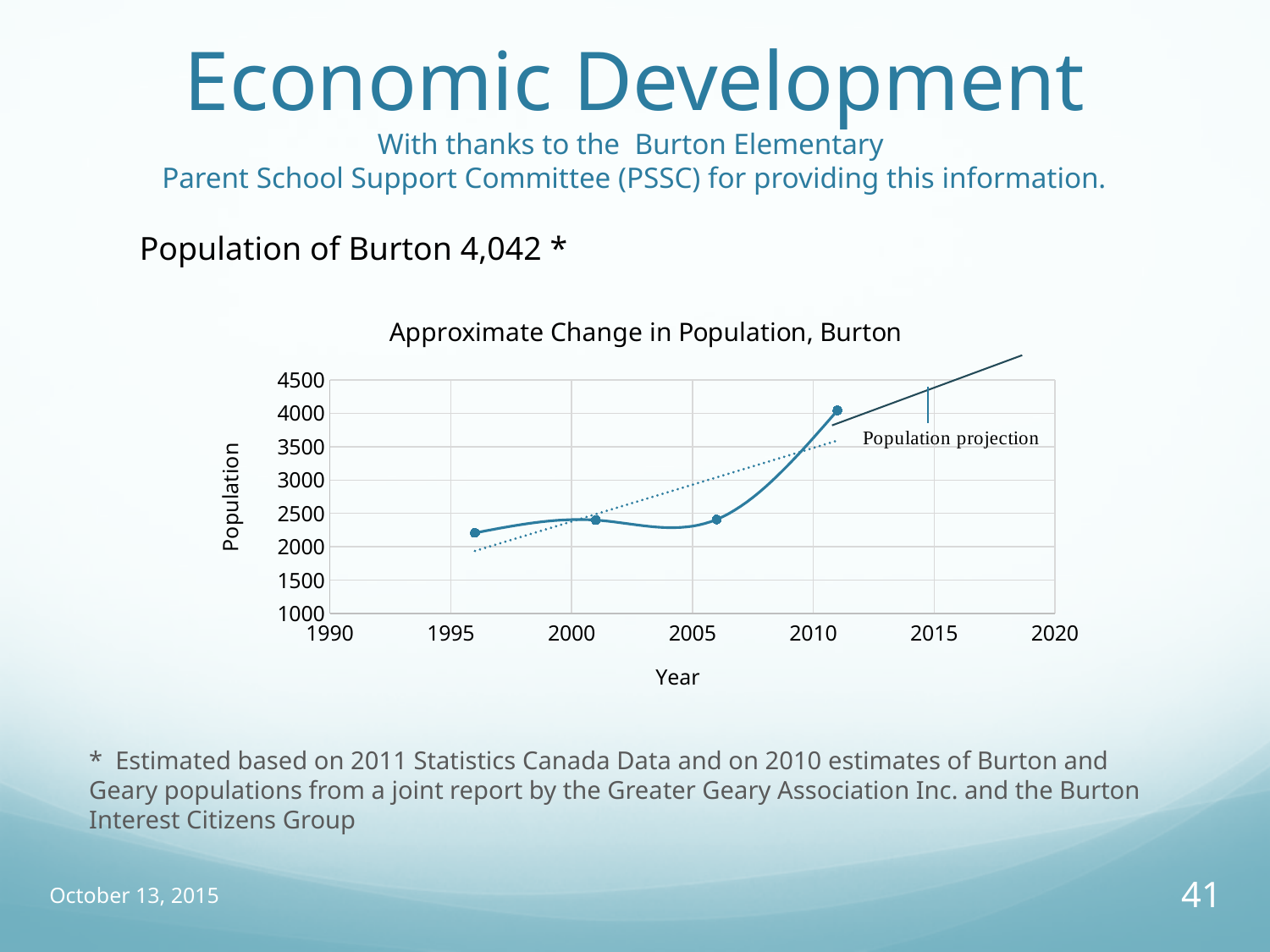
Is the population value for the 2011 point greater or less than 3500? greater How many data points are plotted on the chart? 4 Is the population value for the 2006 point greater or less than 3000? less Which plotted year has the highest population value? 2011 What is the title of the chart? Approximate Change in Population, Burton Is the population value for the 2001 point greater or less than 2000? greater Which plotted year has the lowest population value? 1996 What is the label on the vertical axis of the chart? Population What kind of chart is shown on the slide? line chart Which has the larger population value, the 2006 point or the 2011 point? 2011 Does the population generally rise or fall from 1996 to 2011 on the chart? rise